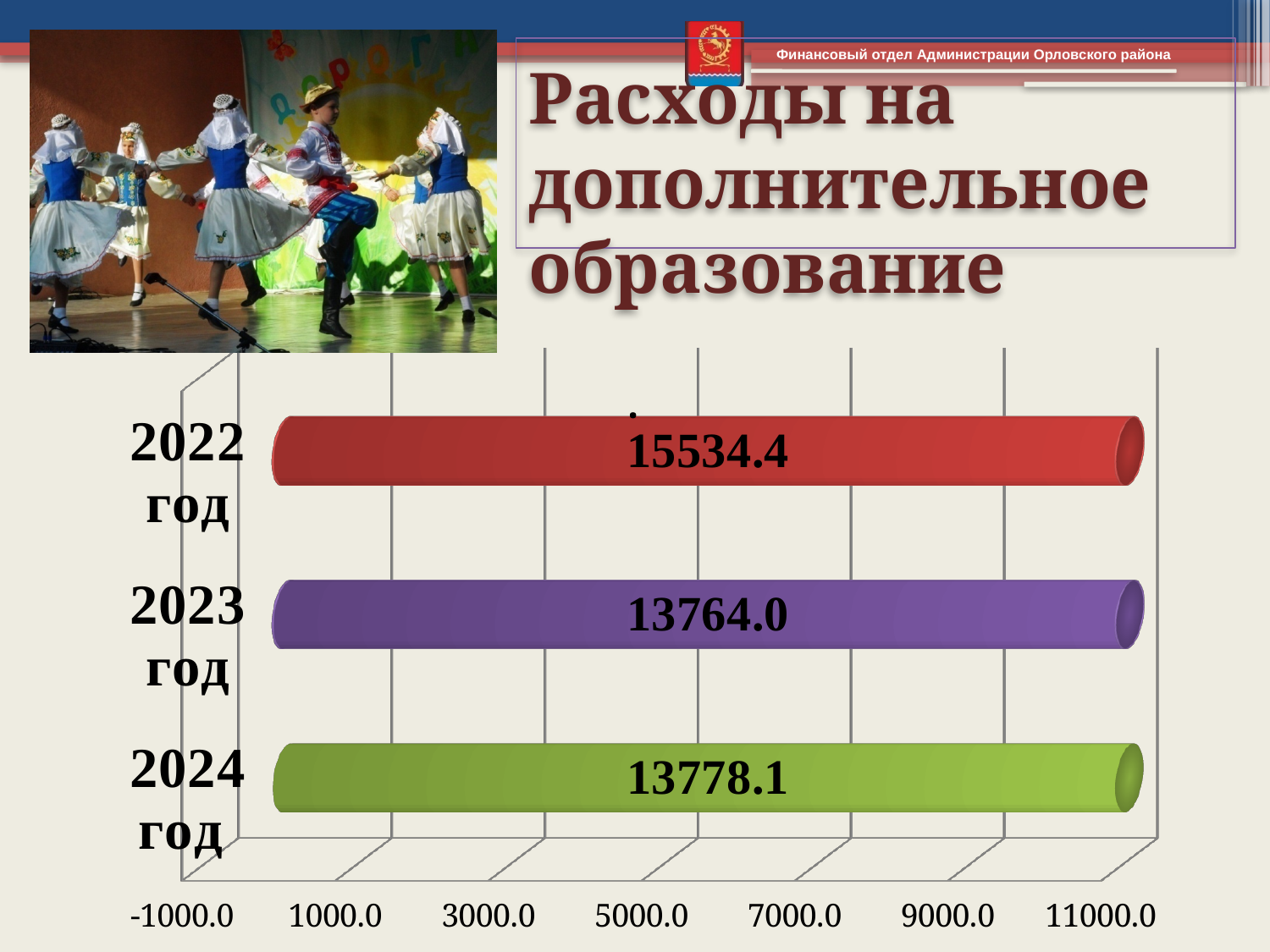
Is the value for 2023 год greater or less than 9000.0? greater What is the value for 2024 год? 13778.1 What is the value for 2022 год? 15534.4 What kind of chart is shown on the slide? bar chart Which is larger, the value for 2022 год or the value for 2023 год? 2022 год What is the difference between the values for 2022 год and 2023 год? 1770.4 What is the title of the slide above the chart? Расходы на дополнительное образование What is the difference between the values for 2022 год and 2024 год? 1756.3 Which year has the highest value? 2022 год What is the value for 2023 год? 13764.0 How many categories (years) are shown in the chart? 3 What is the difference between the values for 2024 год and 2023 год? 14.1